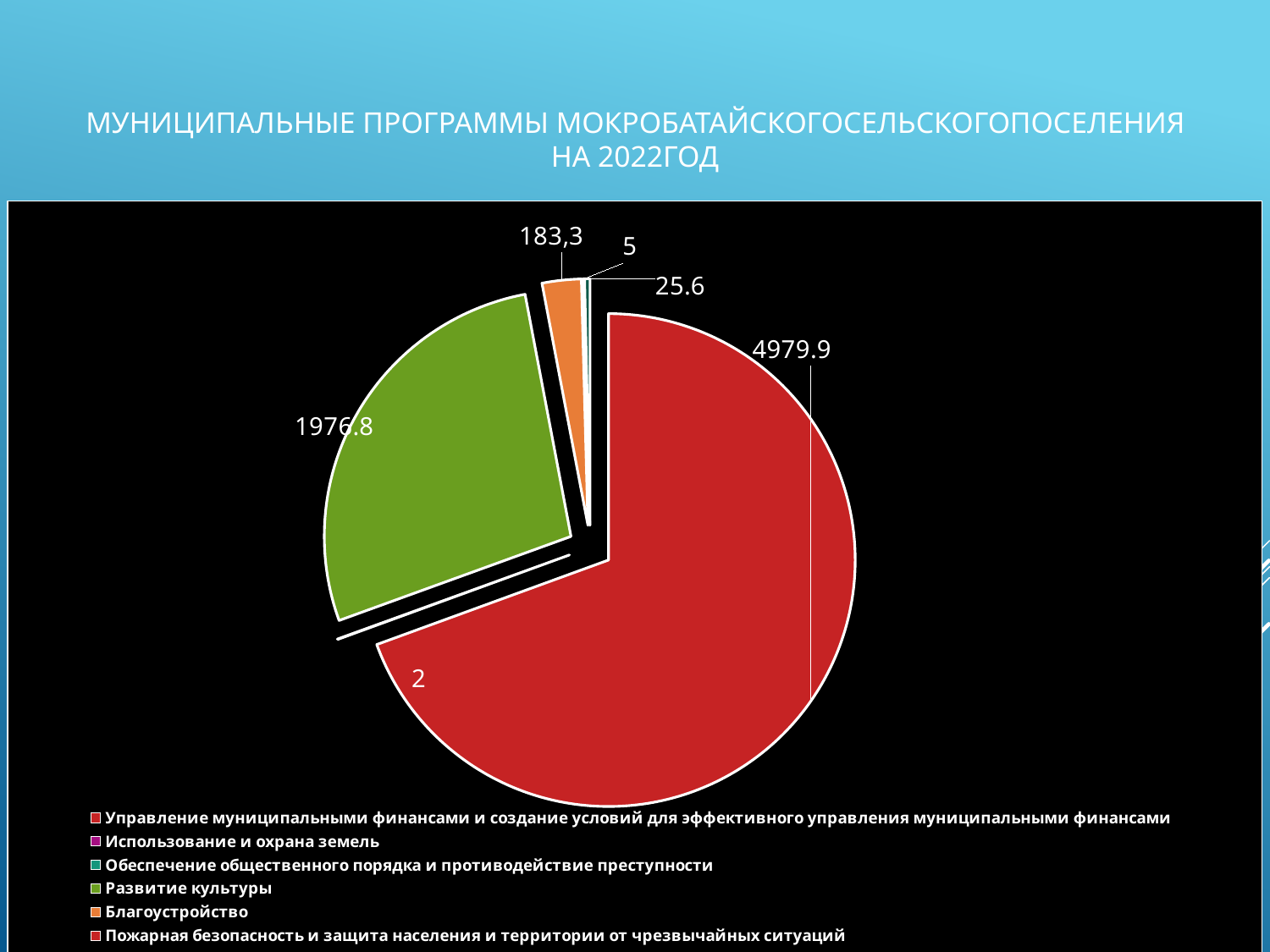
What is the value shown for the Благоустройство slice? 183,3 Which category has the largest slice in the pie chart? Управление муниципальными финансами и создание условий для эффективного управления муниципальными финансами What is the value of the largest slice in the pie chart? 4979.9 What is the value shown for the Развитие культуры slice? 1976.8 Which slice is larger, Развитие культуры or Благоустройство? Развитие культуры What colour is the Развитие культуры slice in the pie chart? green What colour is the Благоустройство slice in the pie chart? orange What kind of chart is shown on the slide? pie chart Is the value of the largest slice greater or less than 4000? greater How many categories does the legend of the pie chart list? 6 What is the difference between the largest slice (4979.9) and the Развитие культуры slice (1976.8)? 3003.1